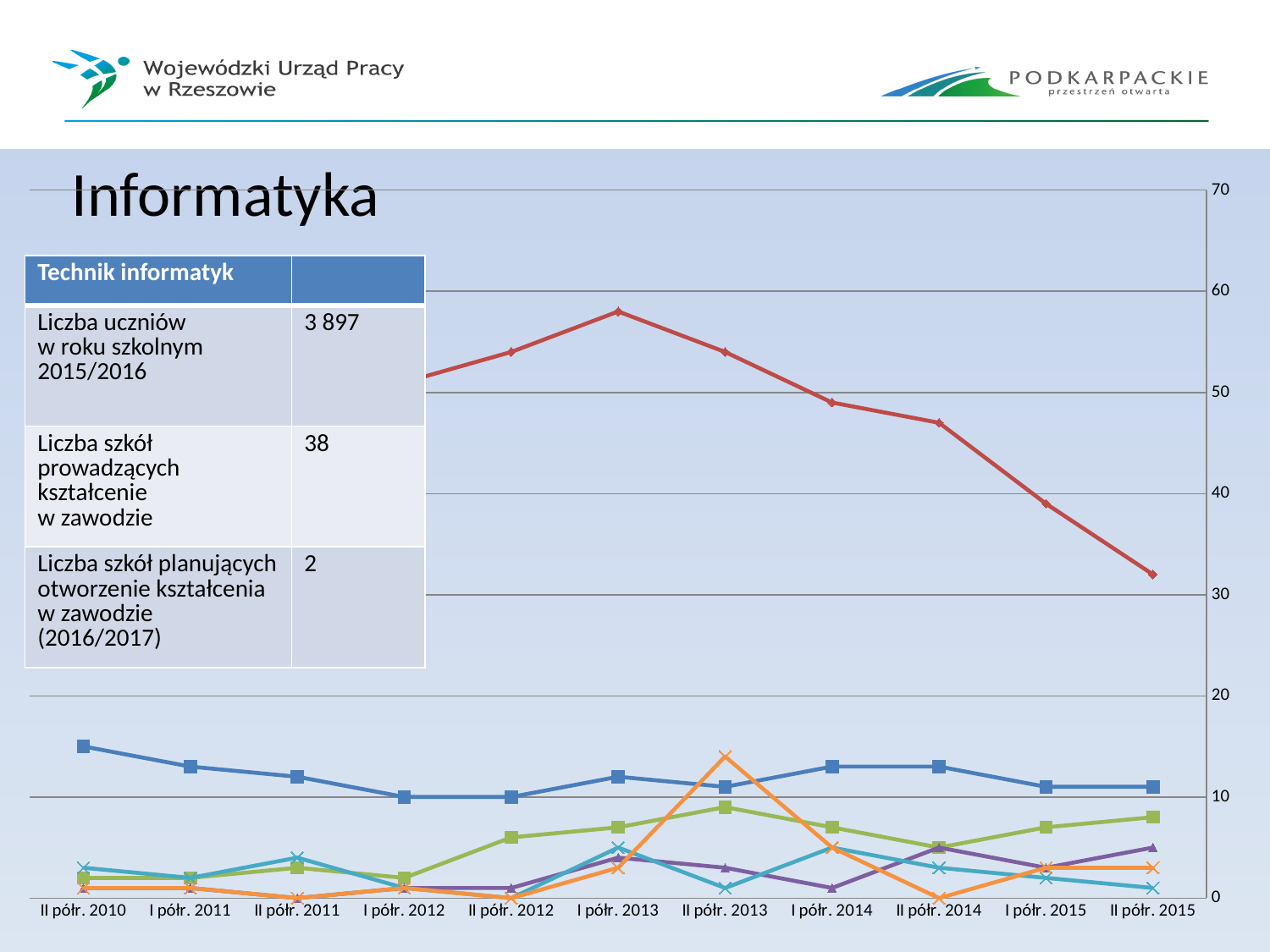
What is the last category on the x axis of the chart? II półr. 2015 Is the value of the orange line at II półr. 2013 greater or less than 10? greater Is the value of the red line at II półr. 2014 greater or less than 50? less Is the value of the red line at I półr. 2013 greater or less than 50? greater Does the red line rise or fall from I półr. 2013 to II półr. 2015? fall How many time periods are shown on the x axis of the chart? 11 What is the first category on the x axis of the chart? II półr. 2010 At II półr. 2015, which is larger: the value of the red line or the value of the blue line? the red line What kind of chart is shown on the slide? line chart